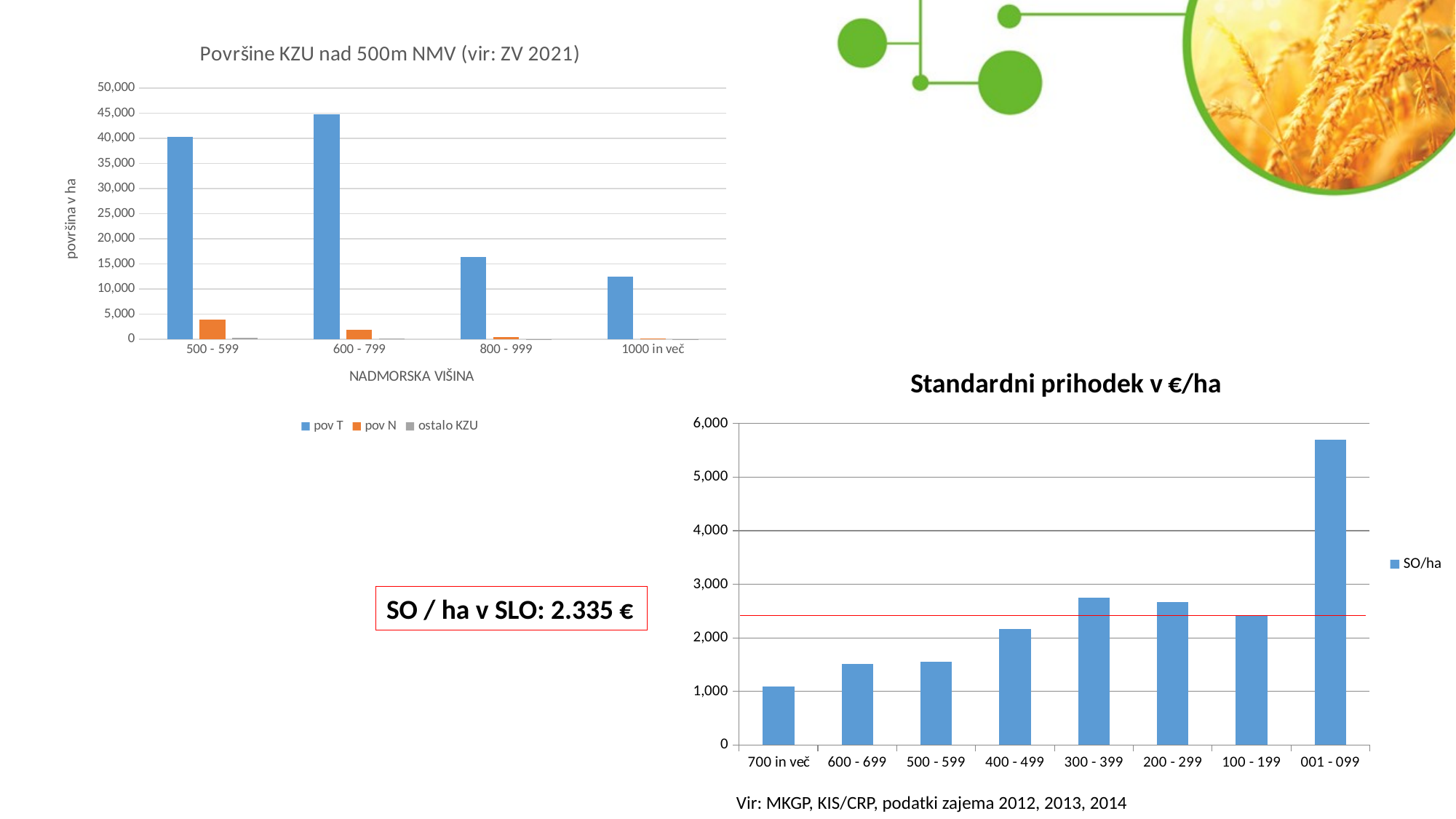
How many altitude categories are shown on the x axis of the chart "Površine KZU nad 500m NMV (vir: ZV 2021)"? 4 How many categories are shown on the x axis of the chart "Standardni prihodek v €/ha"? 8 In the chart "Standardni prihodek v €/ha", which has the larger value: 400 - 499 or 100 - 199? 100 - 199 In the chart "Standardni prihodek v €/ha", which category has the lowest value? 700 in več In the chart "Standardni prihodek v €/ha", which category has the highest value? 001 - 099 In the chart "Površine KZU nad 500m NMV (vir: ZV 2021)", which altitude category has the highest pov T value? 600 - 799 In the chart "Površine KZU nad 500m NMV (vir: ZV 2021)", which has the larger pov N value: 500 - 599 or 600 - 799? 500 - 599 In the chart "Površine KZU nad 500m NMV (vir: ZV 2021)", is the pov T value for 800 - 999 greater or less than 20,000? less In the chart "Standardni prihodek v €/ha", is the value for 001 - 099 greater or less than 5,000? greater How many series does the legend of the chart "Površine KZU nad 500m NMV (vir: ZV 2021)" list? 3 In the chart "Površine KZU nad 500m NMV (vir: ZV 2021)", is the pov T value for 500 - 599 greater or less than 35,000? greater What kind of chart is the chart titled "Površine KZU nad 500m NMV (vir: ZV 2021)"? bar chart